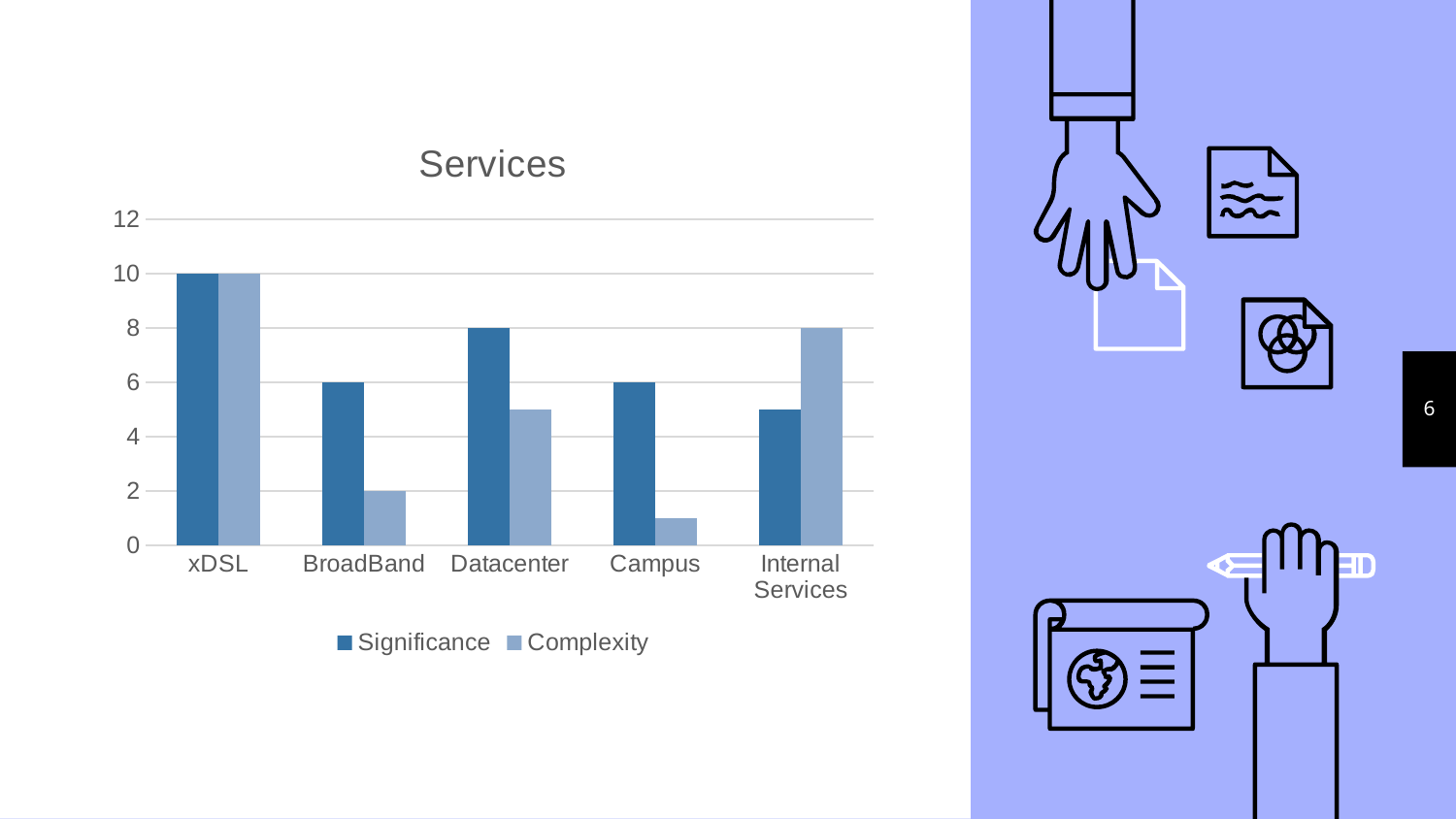
Which category has the highest Significance value? xDSL What is the Complexity value for Internal Services? 8 What type of chart is shown on the slide? bar chart What is the Significance value for xDSL? 10 Is the Complexity value for Datacenter greater or less than 4? greater What is the Complexity value for BroadBand? 2 How many categories are shown on the x axis? 5 What is the difference between the Significance values for xDSL and BroadBand? 4 Which category has the lowest Complexity value? Campus How many series does the legend list? 2 What is the title of the chart? Services What is the Significance value for Datacenter? 8